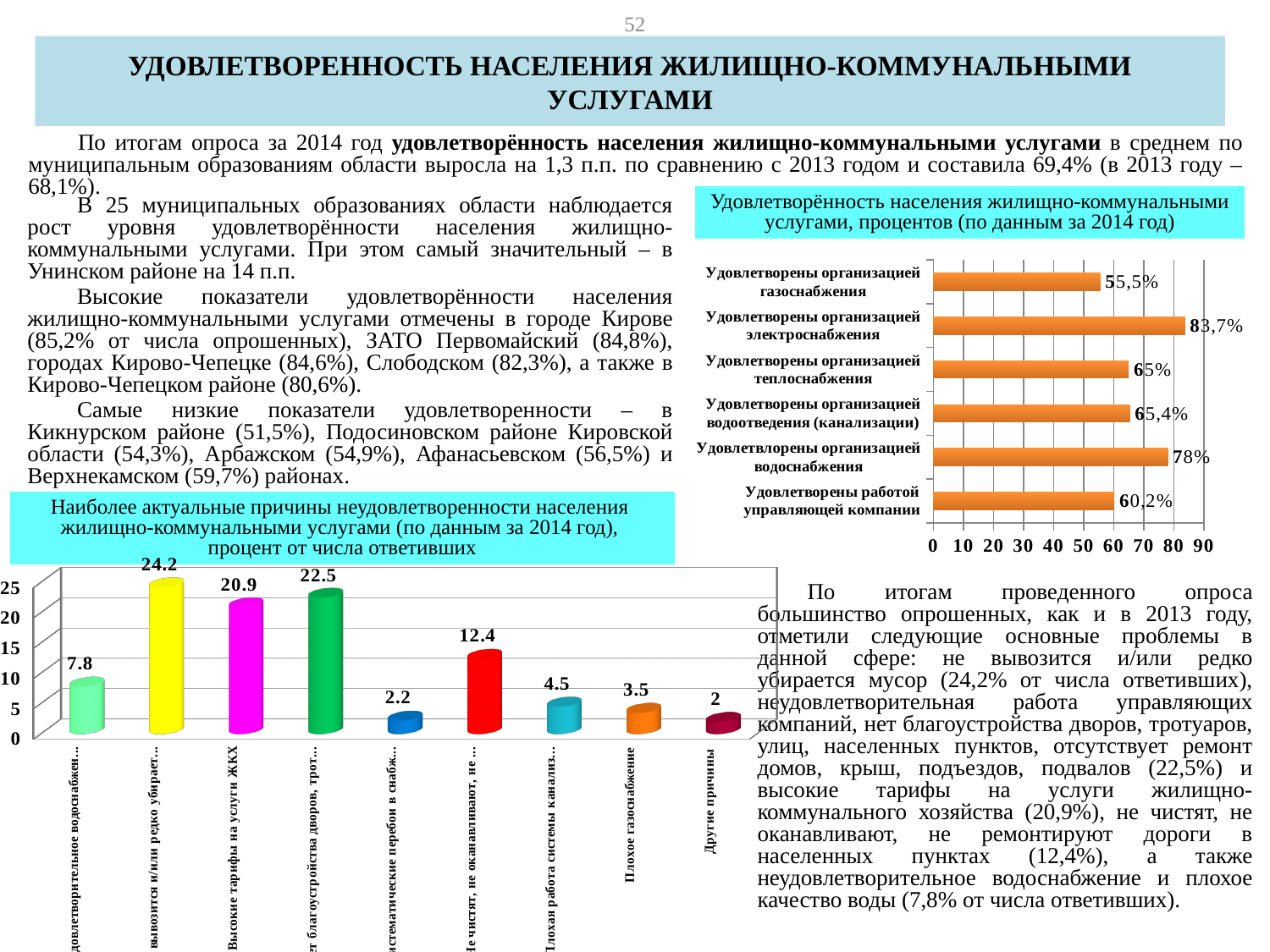
In the chart on the right, which category has the highest value? Удовлетворены организацией электроснабжения In the chart on the right, what is the difference between the values for 'Удовлетворены организацией водоснабжения' and 'Удовлетворены организацией газоснабжения'? 22,5 In the chart on the right, which category has the lowest value? Удовлетворены организацией газоснабжения In the chart 'Удовлетворённость населения жилищно-коммунальными услугами' on the right, what is the value for 'Удовлетворены организацией электроснабжения'? 83,7% What type of chart is the chart on the right? Bar chart In the chart on the right, what is the value for 'Удовлетворены работой управляющей компании'? 60,2% How many categories are shown in the chart on the right? 6 In the bottom chart 'Наиболее актуальные причины неудовлетворенности населения жилищно-коммунальными услугами', what is the value for 'Высокие тарифы на услуги ЖКХ'? 20.9 How many bars are shown in the bottom chart? 9 In the bottom chart, what is the value for 'Другие причины'? 2 In the bottom chart, what is the value for 'Плохое газоснабжение'? 3.5 In the chart on the right, which is larger: the value for 'Удовлетворены организацией водоснабжения' or for 'Удовлетворены организацией теплоснабжения'? Удовлетворены организацией водоснабжения